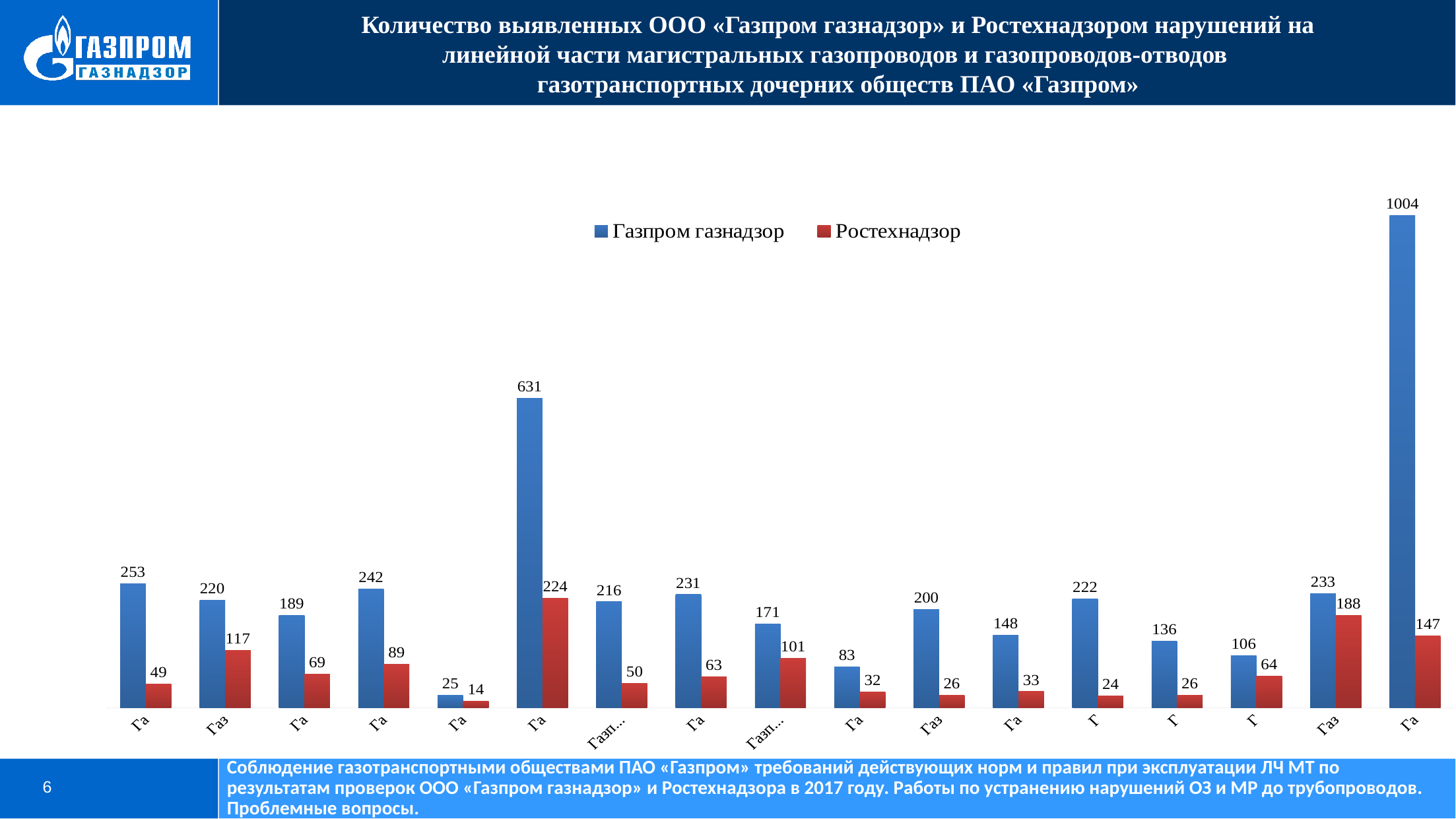
What colour are the bars for the Ростехнадзор series? red What is the highest value shown for the Газпром газнадзор series? 1004 How many categories are plotted along the x axis? 17 What is the lowest value shown for the Ростехнадзор series? 14 In the leftmost category, which series has the larger value, Газпром газнадзор or Ростехнадзор? Газпром газнадзор How many series does the legend list? 2 What is the lowest value shown for the Газпром газнадзор series? 25 What is the highest value shown for the Ростехнадзор series? 224 For the rightmost category, what is the difference between the Газпром газнадзор value (1004) and the Ростехнадзор value (147)? 857 What is the Ростехнадзор value for the rightmost category on the chart? 147 What kind of chart is shown on the slide? bar chart For the category where Газпром газнадзор shows 631, what is the difference between that value and the Ростехнадзор value of 224? 407